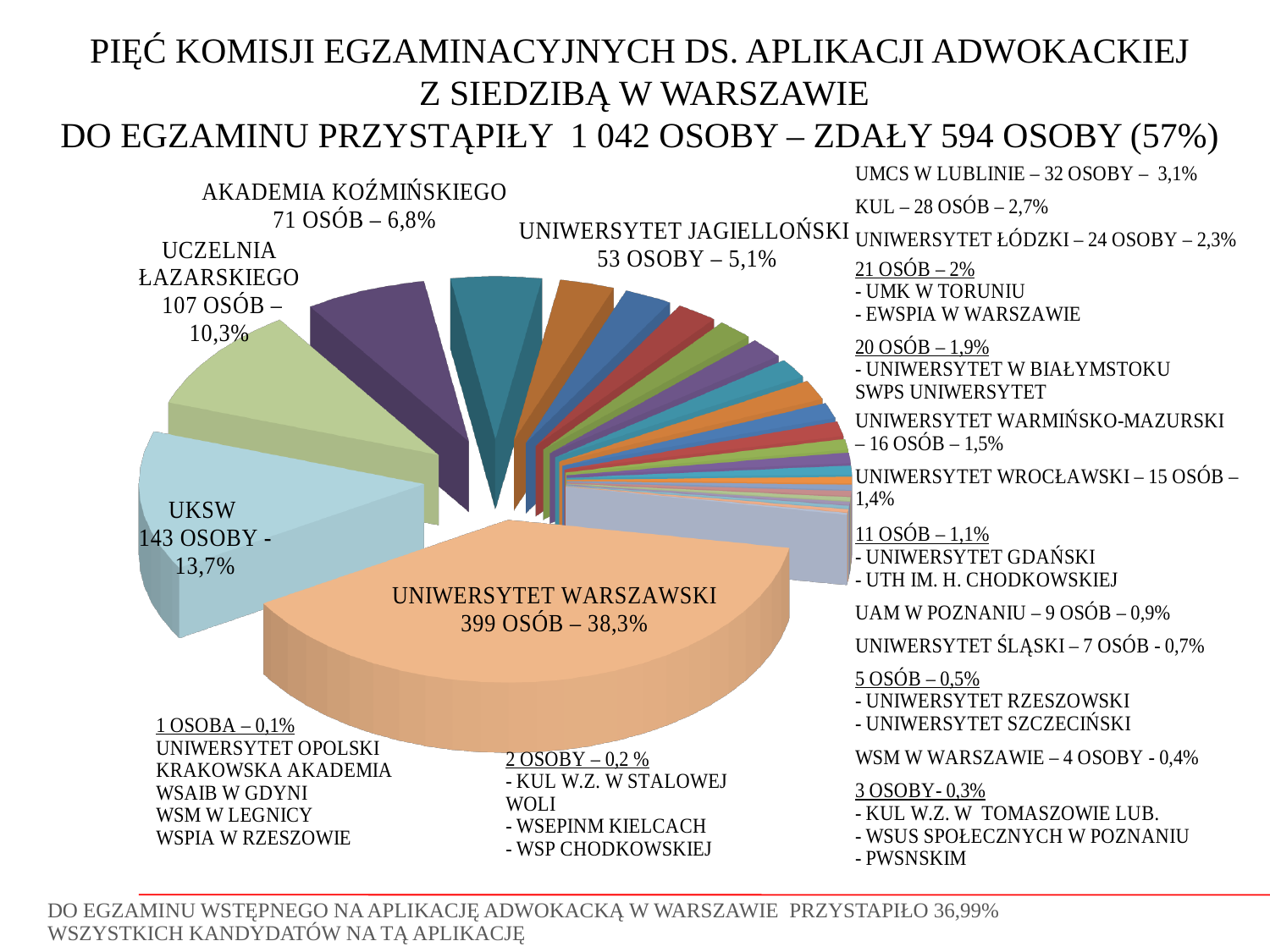
Which university has the largest slice of the pie chart? Uniwersytet Warszawski What kind of chart is shown on the slide? pie chart How many people does the Akademia Koźmińskiego slice represent? 71 osób According to the slide title, how many people took the exam in total? 1 042 osoby What share of the pie does UKSW account for? 13,7% How many people does the Uczelnia Łazarskiego slice represent? 107 osób What is the difference in number of people between Uniwersytet Warszawski and UKSW? 256 Which is larger, the slice for UKSW or the slice for Uczelnia Łazarskiego? UKSW How many people does the Uniwersytet Warszawski slice represent? 399 osób What percentage is shown for UMCS w Lublinie? 3,1% What percentage is shown for Uniwersytet Jagielloński? 5,1% What share of the pie does Uniwersytet Warszawski account for? 38,3%